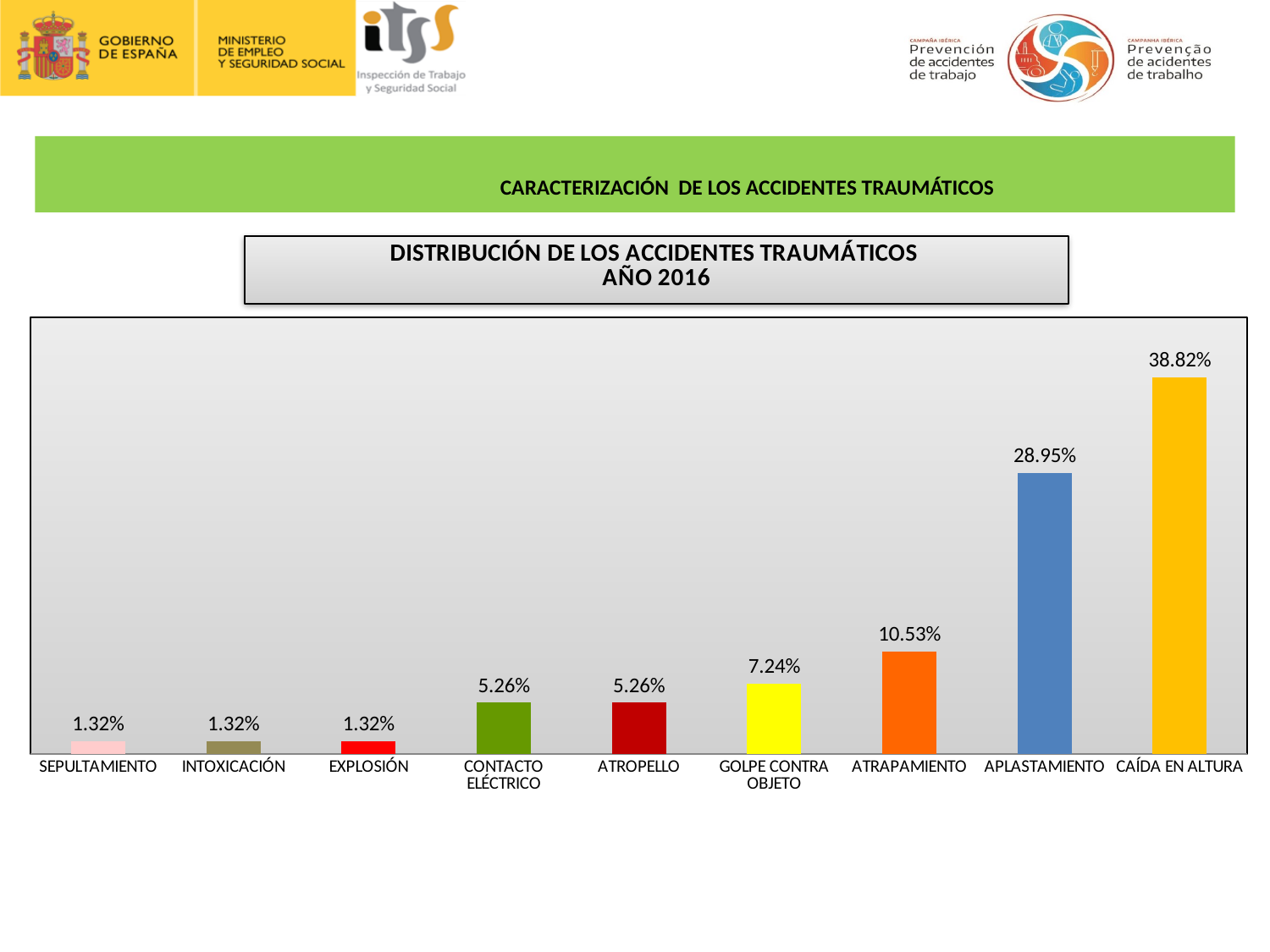
What is the difference between the values for CAÍDA EN ALTURA and APLASTAMIENTO? 9.87% Which category has the highest value? CAÍDA EN ALTURA What kind of chart is shown on the slide? bar chart What is the value for CAÍDA EN ALTURA? 38.82% Which is larger, the value for ATRAPAMIENTO or the value for CONTACTO ELÉCTRICO? ATRAPAMIENTO What is the value for ATROPELLO? 5.26% What is the value for GOLPE CONTRA OBJETO? 7.24% What is the value for APLASTAMIENTO? 28.95% What is the title shown above the chart? DISTRIBUCIÓN DE LOS ACCIDENTES TRAUMÁTICOS AÑO 2016 How many categories are shown on the x axis? 9 What is the value for ATRAPAMIENTO? 10.53% What is the difference between the values for ATRAPAMIENTO and GOLPE CONTRA OBJETO? 3.29%